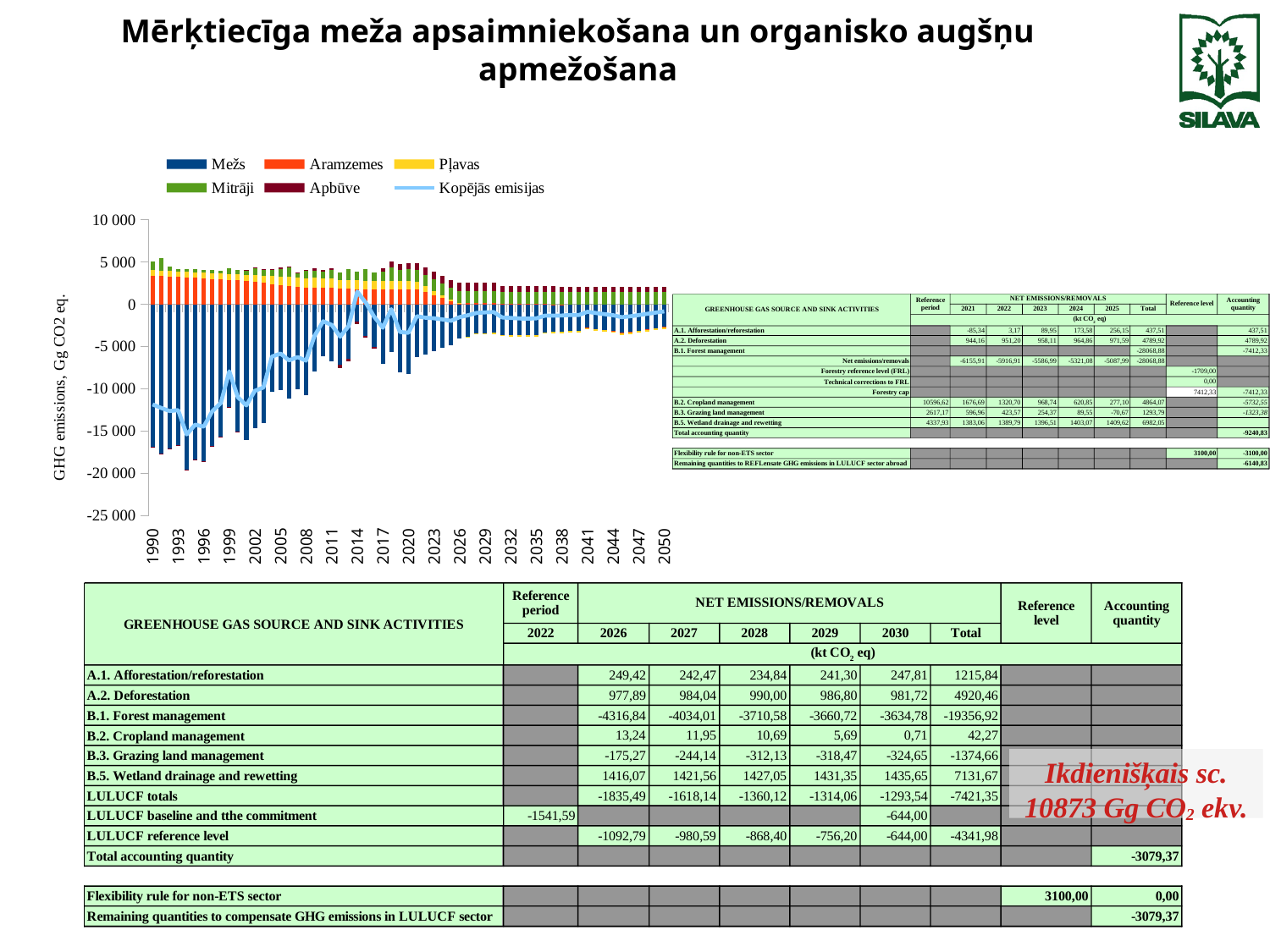
How many year labels are shown on the horizontal axis? 21 What is the last year labelled on the horizontal axis? 2050 What is the highest value shown on the vertical axis? 10 000 What is the first year labelled on the horizontal axis? 1990 Is the Kopējās emisijas value for 1990 greater or less than -10 000? less How many series does the chart legend list? 6 Does the Kopējās emisijas line generally rise or fall from 1990 to 2050? rise Which series is drawn as a line rather than as bars? Kopējās emisijas Is the Kopējās emisijas value for 2050 greater or less than -5 000? greater What is the lowest value shown on the vertical axis? -25 000 What is the label of the vertical axis? GHG emissions, Gg CO2 eq. What kind of chart is shown on the slide? combination bar and line chart